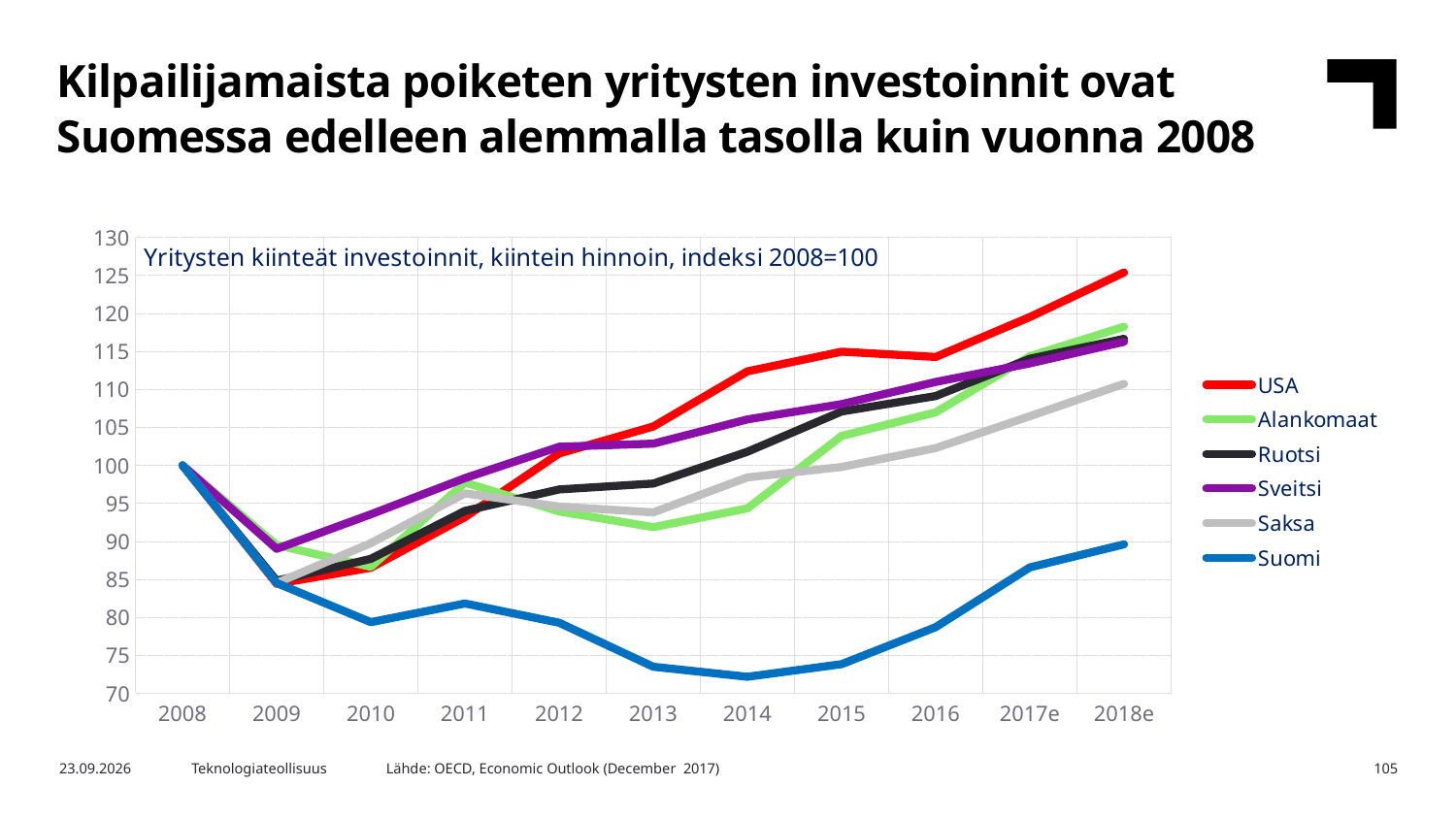
Which country has the highest value in 2018e? USA Is the value for USA in 2018e greater or less than 120? greater What is the title of the chart? Yritysten kiinteät investoinnit, kiintein hinnoin, indeksi 2008=100 How many years are shown on the x axis? 11 How many series does the legend list? 6 Is the value for Suomi in 2014 greater or less than 75? less Which country has the lowest value in 2018e? Suomi What kind of chart is shown on the slide? line chart What is the index value for Suomi in 2008? 100 Does the value for Suomi rise or fall from 2008 to 2014? fall Which country has the highest value in 2014? USA Which is larger in 2018e, the value for Sveitsi or the value for Saksa? Sveitsi